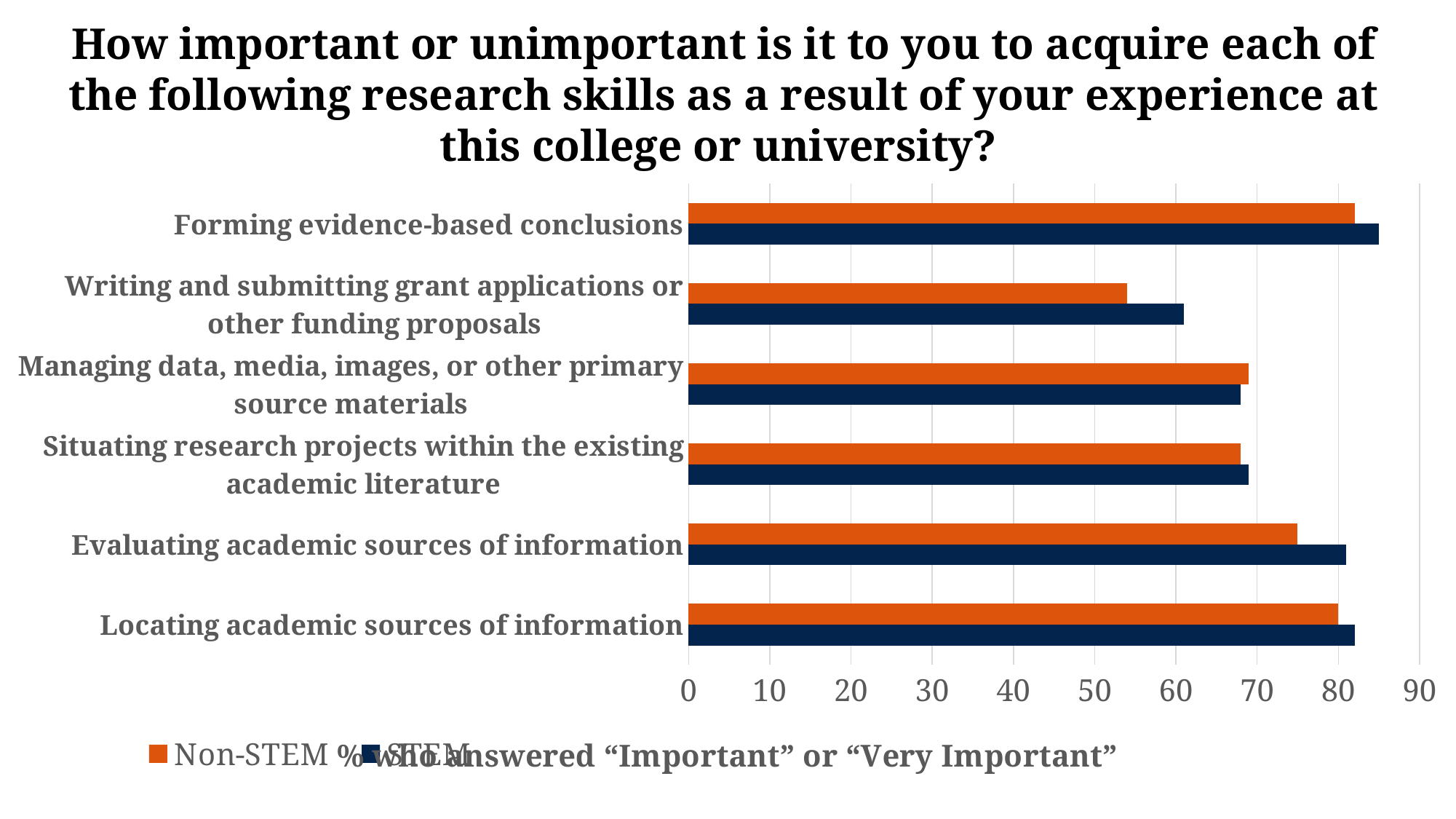
Is the STEM value for "Situating research projects within the existing academic literature" greater or less than 80? less Which category has the lowest Non-STEM value? Writing and submitting grant applications or other funding proposals How many series does the legend list? 2 Which series is shown in orange? Non-STEM How many research skill categories are plotted on the chart? 6 For "Writing and submitting grant applications or other funding proposals", which series has the larger value, STEM or Non-STEM? STEM What kind of chart is shown on the slide? Bar chart Which category has the highest STEM value? Forming evidence-based conclusions Is the Non-STEM value for "Writing and submitting grant applications or other funding proposals" greater or less than 60? less Is the Non-STEM value for "Evaluating academic sources of information" greater or less than 70? greater For "Evaluating academic sources of information", which series has the larger value, STEM or Non-STEM? STEM